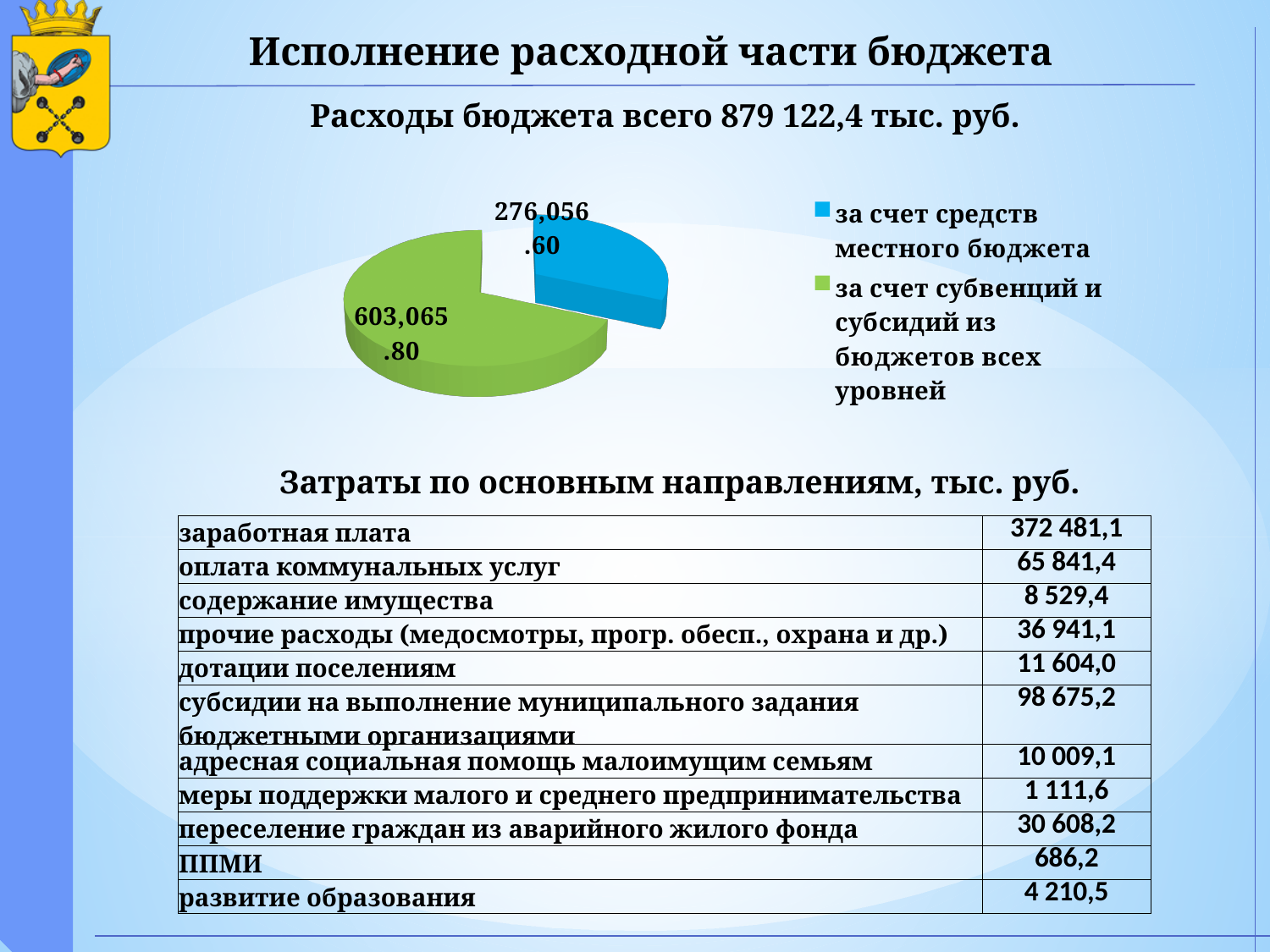
Which slice of the pie chart is the largest? за счет субвенций и субсидий из бюджетов всех уровней What is the value of the slice 'за счет средств местного бюджета' in the pie chart? 276,056.60 What is the value of the slice 'за счет субвенций и субсидий из бюджетов всех уровней' in the pie chart? 603,065.80 What kind of chart is shown on the slide? pie chart Which slice of the pie chart is the smallest? за счет средств местного бюджета How many slices does the pie chart have? 2 What colour is the slice 'за счет средств местного бюджета' in the pie chart? blue What colour is the slice 'за счет субвенций и субсидий из бюджетов всех уровней' in the pie chart? green What is the total of the two slices of the pie chart, as stated on the slide? 879 122,4 тыс. руб. What is the difference between the two slices of the pie chart (603,065.80 minus 276,056.60)? 327,009.20 How many entries does the legend of the pie chart list? 2 Which is larger in the pie chart: the slice for local budget funds (за счет средств местного бюджета) or the slice for subventions and subsidies (за счет субвенций и субсидий)? за счет субвенций и субсидий из бюджетов всех уровней